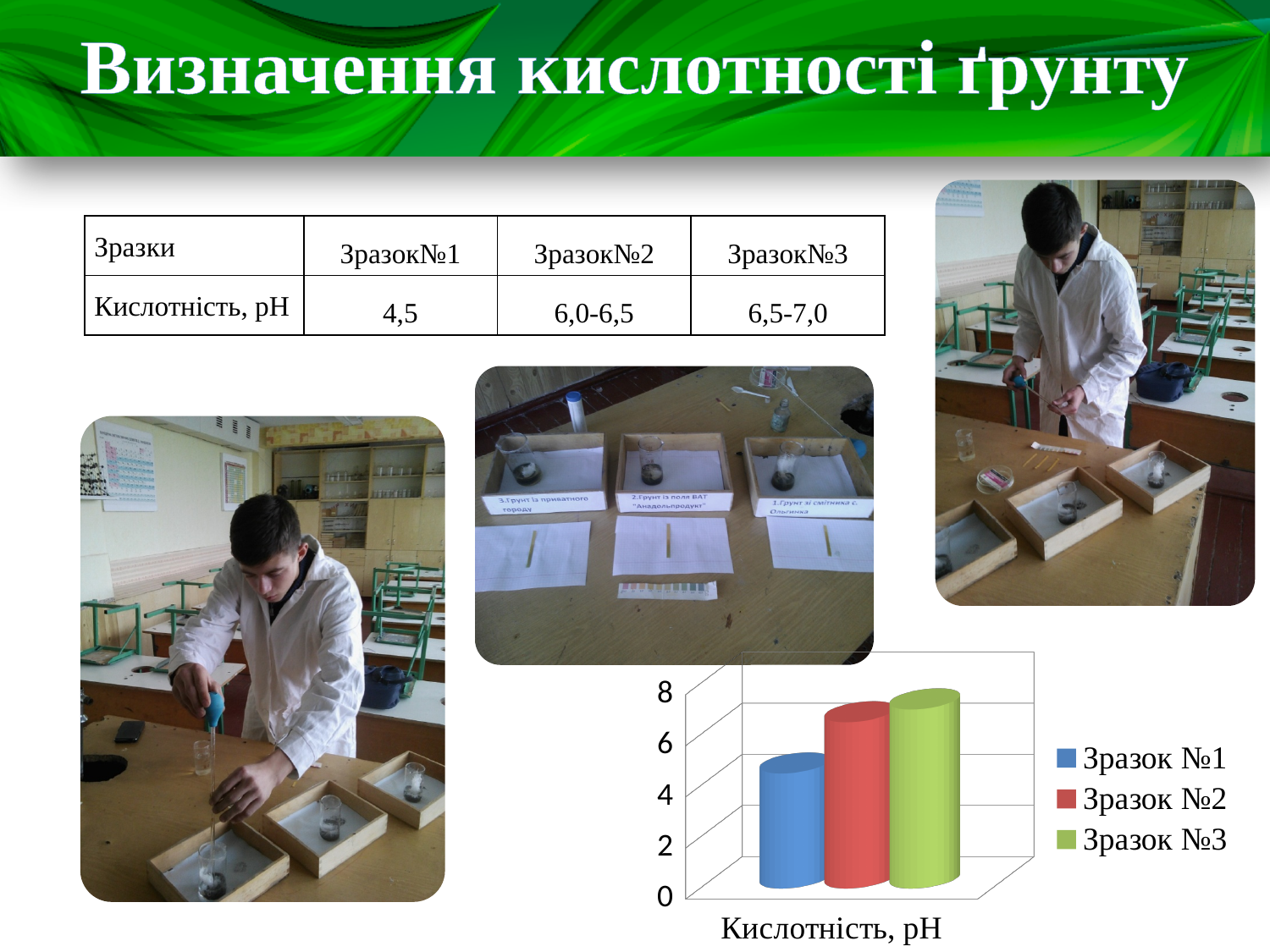
How many series does the chart legend list? 3 Is the value for Зразок №1 in the chart greater or less than 6? less Is the value for Зразок №2 in the chart greater or less than 4? greater What kind of chart is shown on the slide? bar chart Which series has the highest bar in the chart? Зразок №3 What colour is the bar for Зразок №2 in the chart? red Is the value for Зразок №3 in the chart greater or less than 6? greater How many categories are plotted along the x axis of the chart? 1 Which is larger in the chart, the bar for Зразок №1 or the bar for Зразок №2? Зразок №2 Which series has the lowest bar in the chart? Зразок №1 What is the label shown under the x axis of the chart? Кислотність, pH